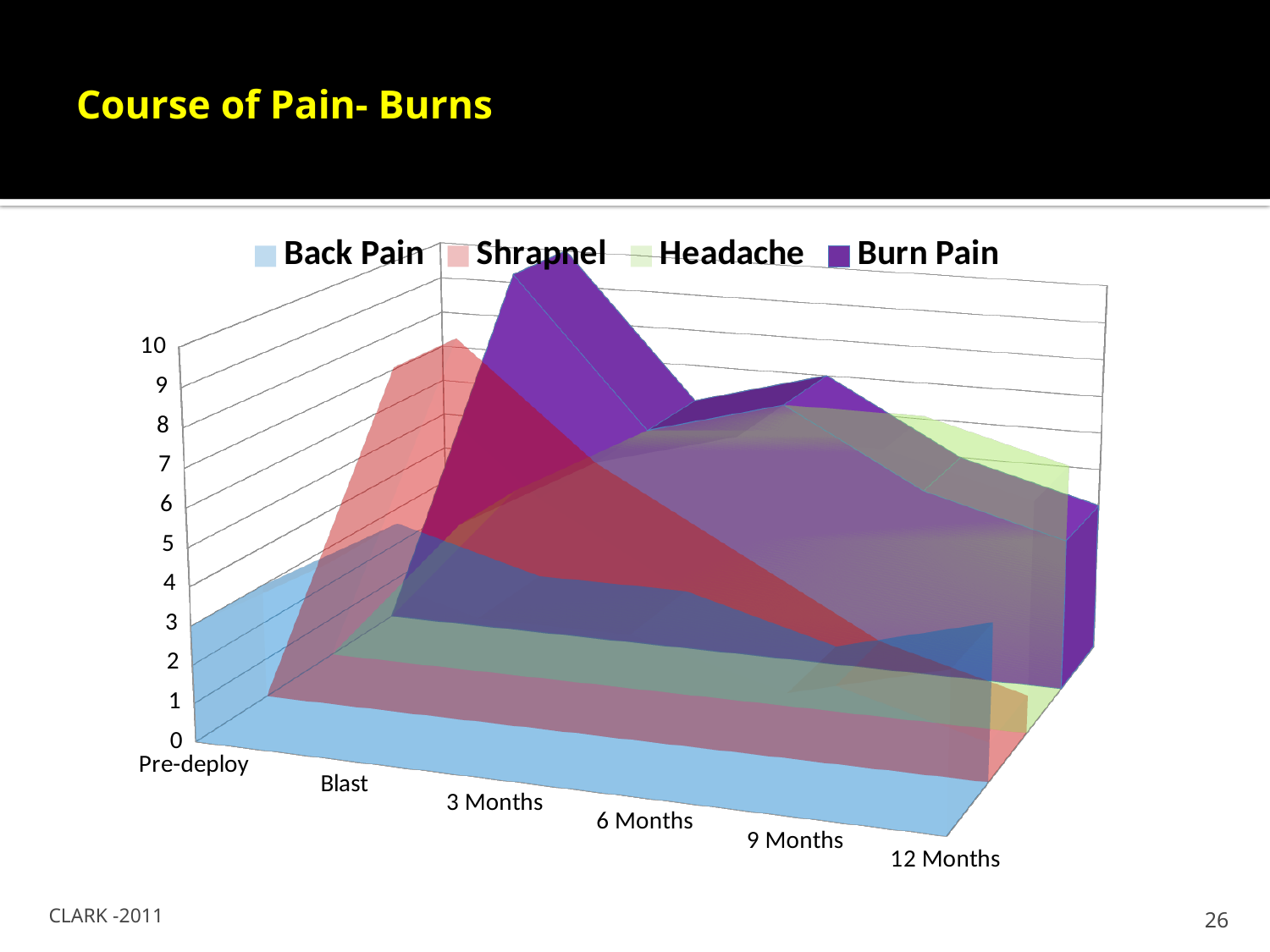
Is the value for Burn Pain at Blast greater or less than 5? greater What is the maximum value shown on the vertical axis? 10 Does the Shrapnel series rise or fall from Blast to 12 Months? fall How many series does the legend list? 4 What is the first category on the x axis? Pre-deploy How many time-point categories are shown along the x axis? 6 What is the title of the slide containing the chart? Course of Pain- Burns Which series is shown in purple in the legend? Burn Pain Is the value for Shrapnel at Blast greater or less than 5? greater At which time point does the Burn Pain series reach its highest value? Blast At which time point does the Shrapnel series reach its highest value? Blast What kind of chart is shown on the slide? area chart